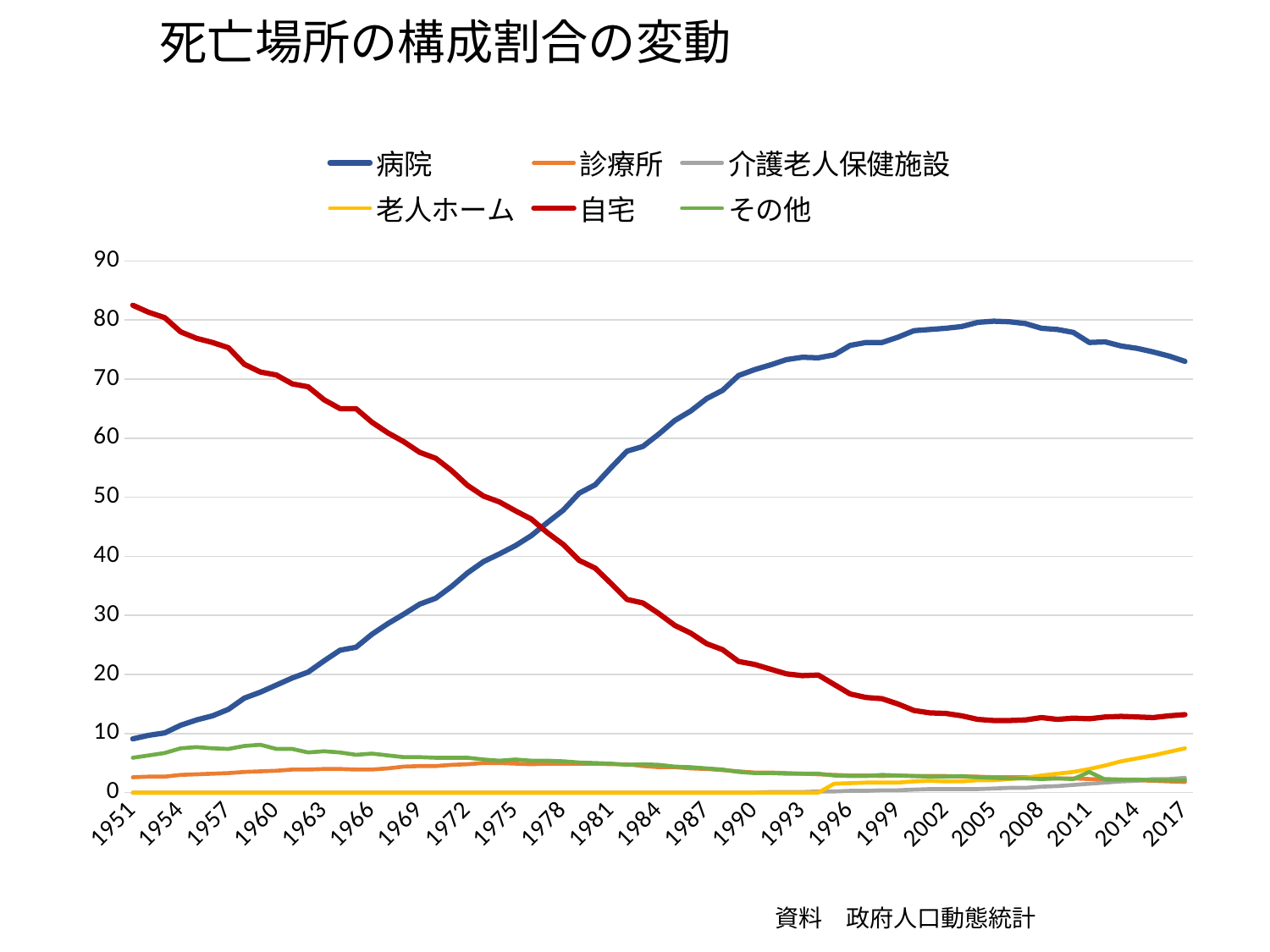
Is the value for 自宅 in 2017 greater or less than 20? less How many series does the legend list? 6 What source is cited below the chart? 政府人口動態統計 What is the title of the chart? 死亡場所の構成割合の変動 Does the 老人ホーム line rise or fall between 1996 and 2017? rise What kind of chart is shown on the slide? line chart Is the value for 病院 in 2017 greater or less than 70? greater Is the value for 病院 in 1951 greater or less than 20? less Which series has the highest value in 2017? 病院 Does the 自宅 line rise or fall between 1951 and 2017? fall In 1951, which is larger, 病院 or 自宅? 自宅 Does the 病院 line rise or fall between 1951 and 2005? rise